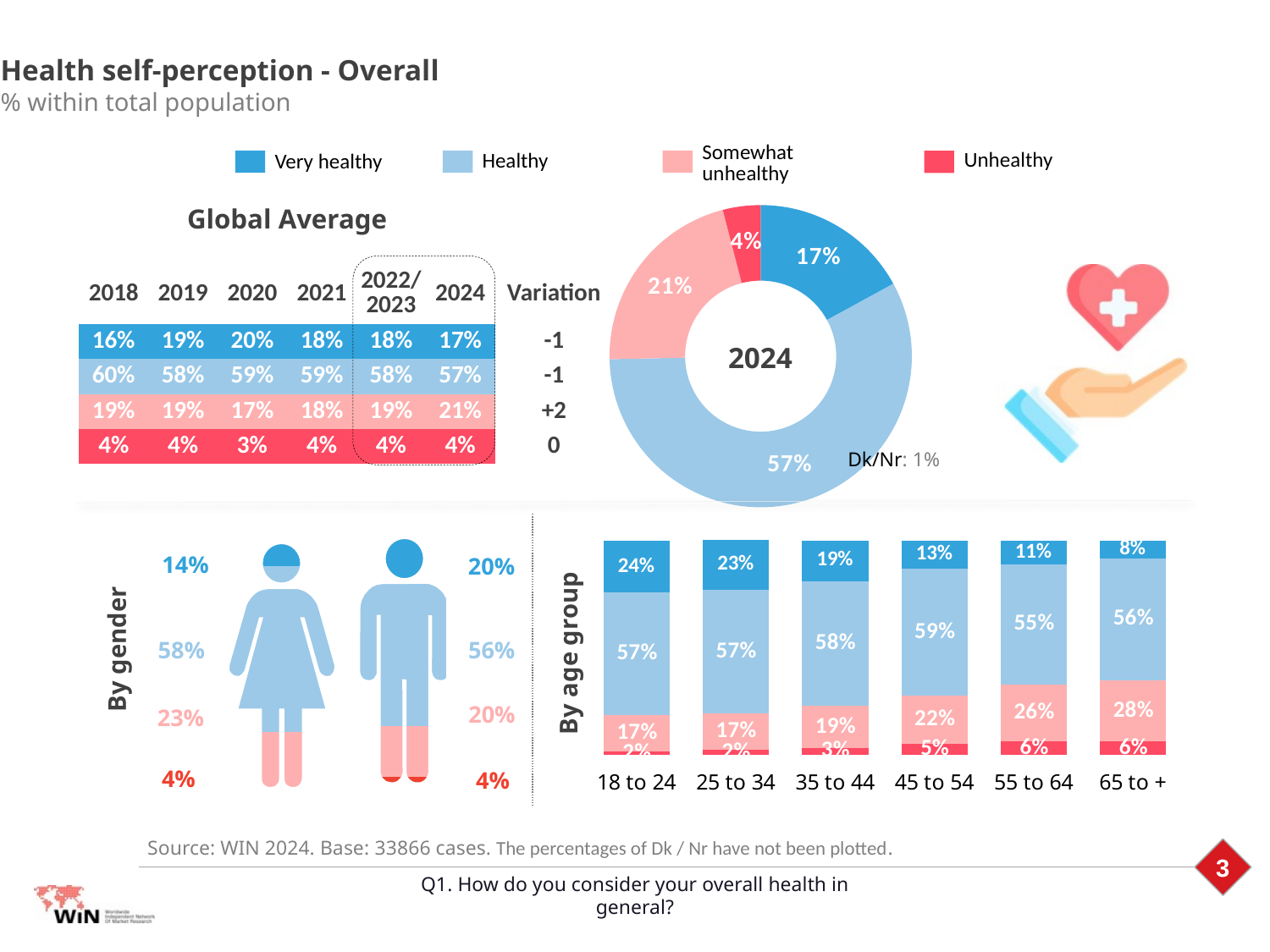
How many age groups are shown in the By age group chart? 6 How many series does the legend at the top of the slide list? 4 In the 2024 donut chart, what percentage of respondents said they are Healthy? 57% In the 2024 donut chart, which category has the largest share? Healthy In the 2024 donut chart, what is the share for Somewhat unhealthy? 21% In the By age group chart, does the Very healthy value rise or fall as age increases from 18 to 24 to 65 to +? Fall In the By age group chart, what is the Somewhat unhealthy value for the 65 to + group? 28% In the By age group chart, which age group has the lowest Very healthy value? 65 to + In the 2024 donut chart, which category has the smallest share? Unhealthy In the By age group chart, which age group has the highest Very healthy value? 18 to 24 In the By age group chart, what is the Very healthy value for the 18 to 24 group? 24% What kind of chart is the By age group chart? Stacked bar chart